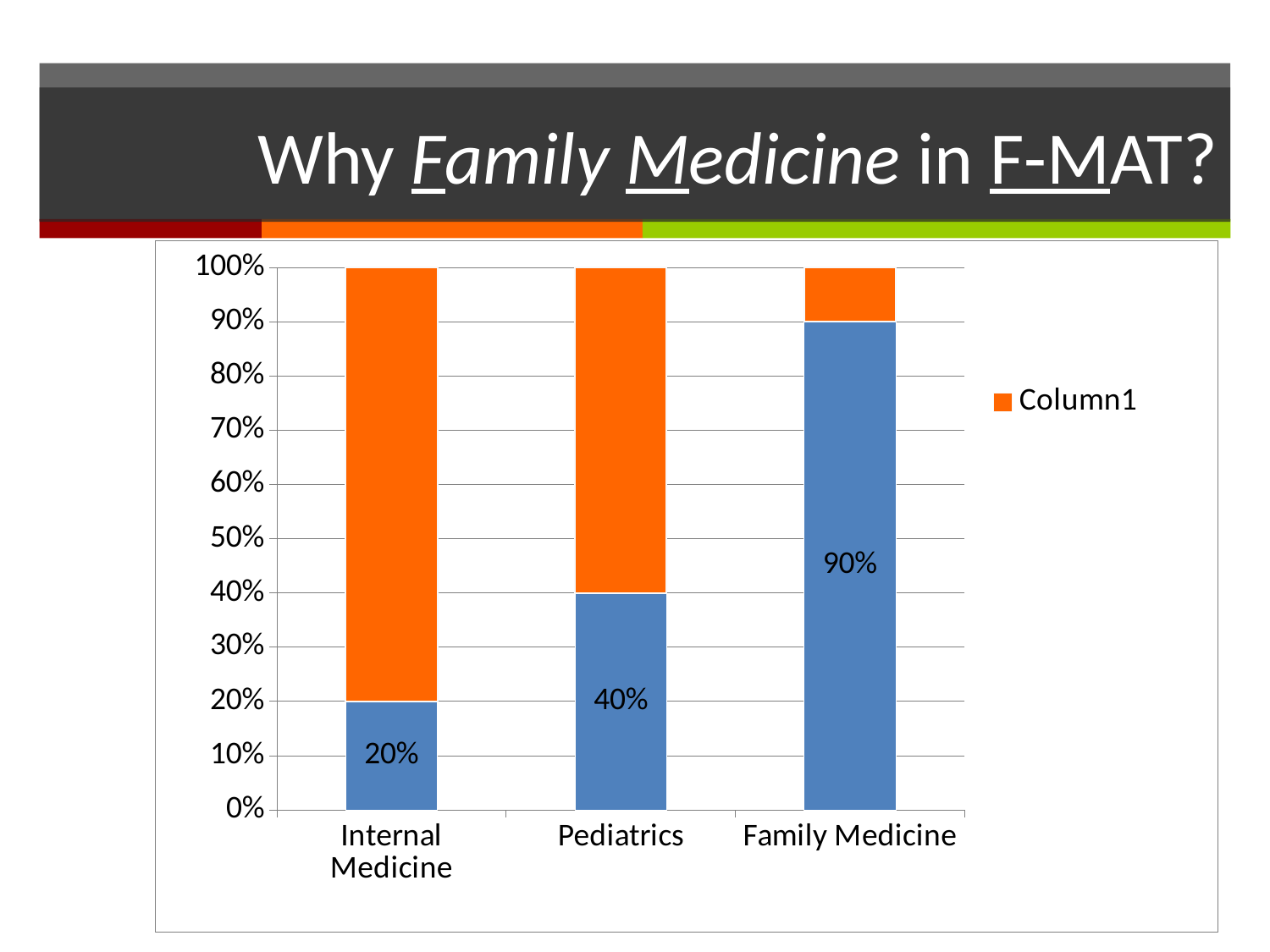
What is the difference between the blue segment values for Family Medicine and Internal Medicine? 70% Which category has the highest blue segment value? Family Medicine Do the blue segment values rise or fall from Internal Medicine to Family Medicine? Rise What is the value of the blue segment for Internal Medicine? 20% What is the value of the blue segment for Family Medicine? 90% Is the orange segment for Internal Medicine greater or less than 50%? greater What kind of chart is shown on the slide? Stacked bar chart What is the value of the blue segment for Pediatrics? 40% How many series does the legend list? 1 Which category has the lowest blue segment value? Internal Medicine How many categories are shown on the x axis? 3 Which has a larger blue segment value, Pediatrics or Internal Medicine? Pediatrics